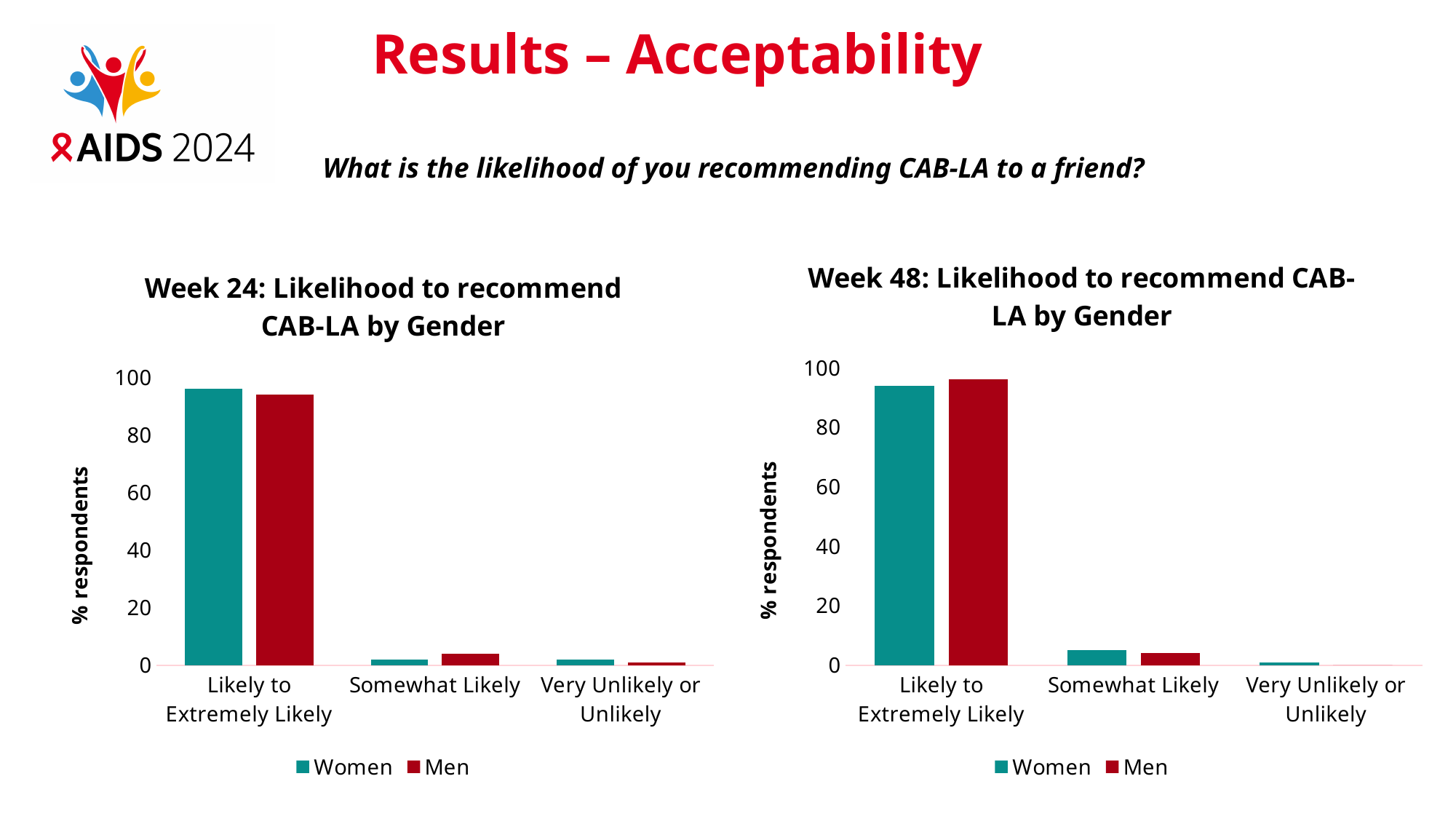
In the Week 48 chart, which category has the lowest value for Men? Very Unlikely or Unlikely In the Week 24 chart, which category has the highest value for Women? Likely to Extremely Likely In the Week 24 chart, how many series does the legend list? 2 In the Week 48 chart, is the value for Women in the Somewhat Likely category greater or less than 20? less In the Week 24 chart, which is larger in the Somewhat Likely category, Women or Men? Men In the Week 24 chart, do the values for Men rise or fall from Likely to Extremely Likely to Very Unlikely or Unlikely? fall In the Week 48 chart, how many categories are shown on the x axis? 3 In the Week 24 chart, what kind of chart is shown? bar chart In the Week 48 chart, which is larger in the Likely to Extremely Likely category, Women or Men? Men What is the y-axis label of the Week 48 chart? % respondents In the Week 24 chart, which colour represents Women? teal In the Week 24 chart, is the value for Women in the Likely to Extremely Likely category greater or less than 80? greater